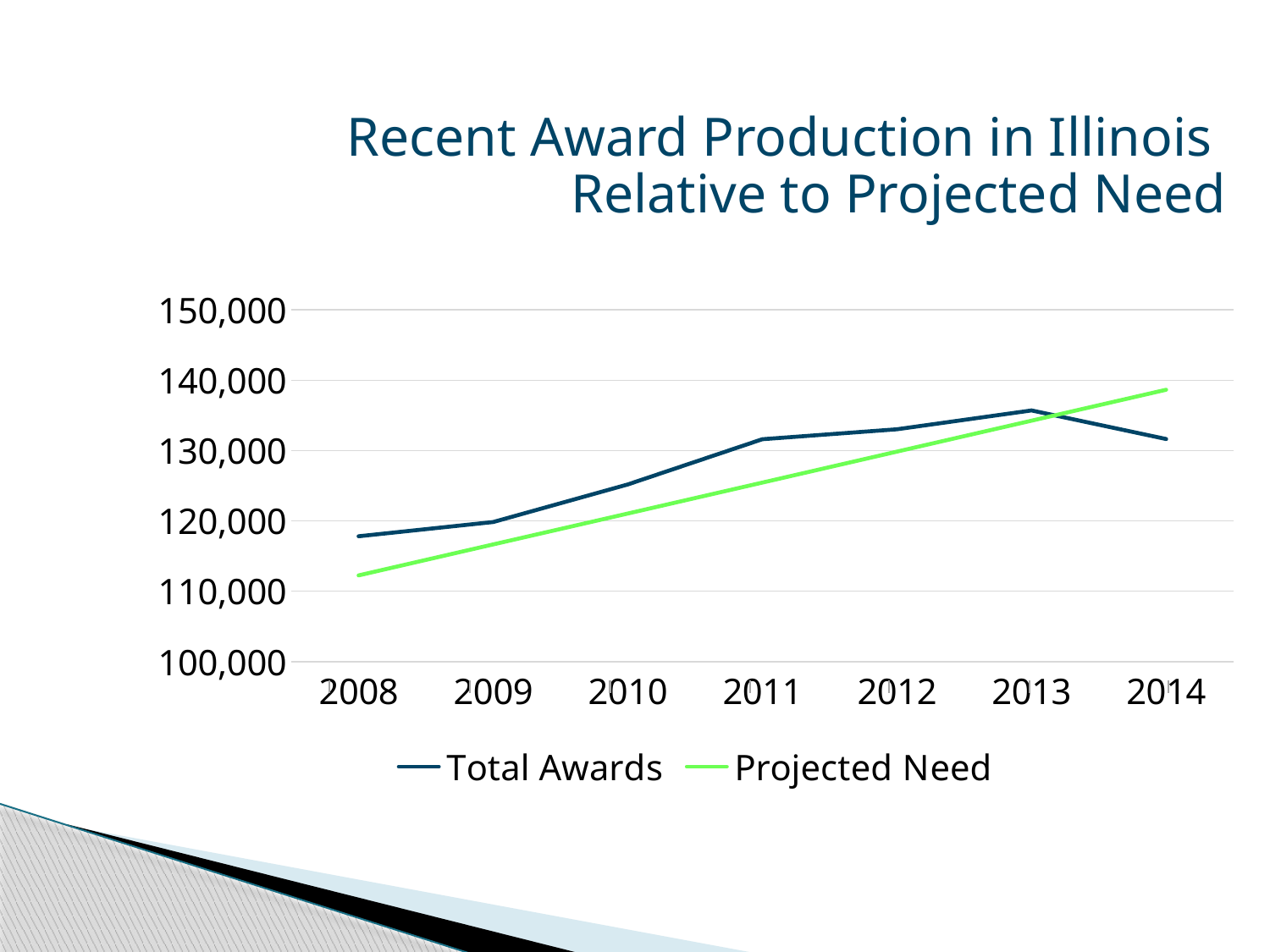
How many years are plotted along the x axis? 7 In which year is the Total Awards value lowest? 2008 Does the Projected Need line rise or fall from 2008 to 2014? Rises Is the Total Awards value for 2011 greater or less than 130,000? greater In which year does the Total Awards line reach its highest point? 2013 How many series does the legend list? 2 What kind of chart is shown on the slide? Line chart Is the Total Awards value for 2008 greater or less than 120,000? less In 2008, which is higher: Total Awards or Projected Need? Total Awards In 2014, which is higher: Total Awards or Projected Need? Projected Need Is the Projected Need value for 2014 greater or less than 140,000? less What is the title of the chart? Recent Award Production in Illinois Relative to Projected Need